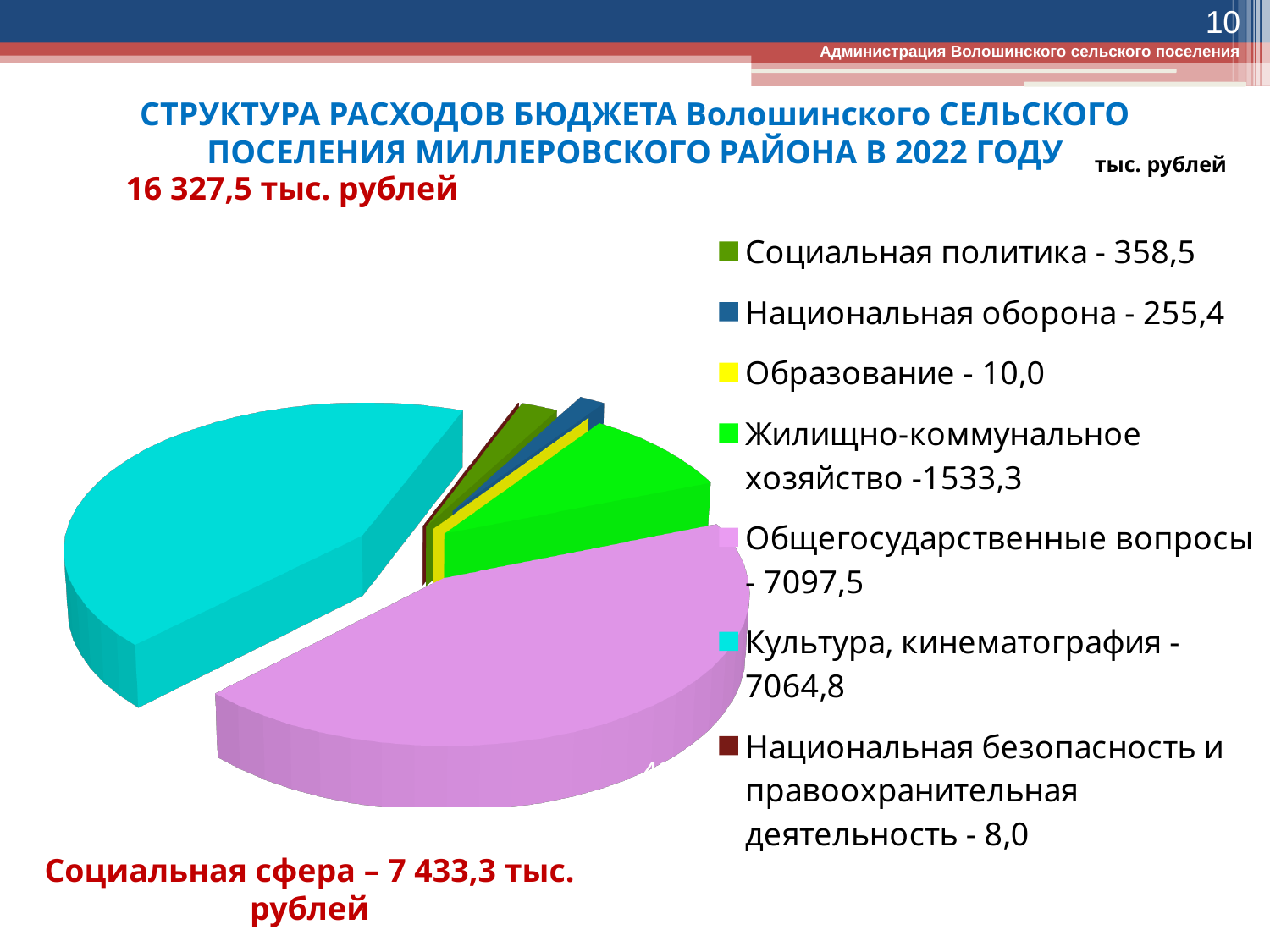
What is the value for Общегосударственные вопросы? 7097,5 Which category has the largest value? Общегосударственные вопросы What is the total budget expenditure shown on the slide? 16 327,5 тыс. рублей In what units are the chart values given? тыс. рублей What is the difference between Общегосударственные вопросы and Культура, кинематография? 32,7 Which is larger: Социальная политика or Национальная оборона? Социальная политика How many categories does the pie chart's legend list? 7 What kind of chart is shown on the slide? Pie chart What is the value for Жилищно-коммунальное хозяйство? 1533,3 Which category has the smallest value? Национальная безопасность и правоохранительная деятельность What is the value for Культура, кинематография? 7064,8 What is the value for Национальная оборона? 255,4